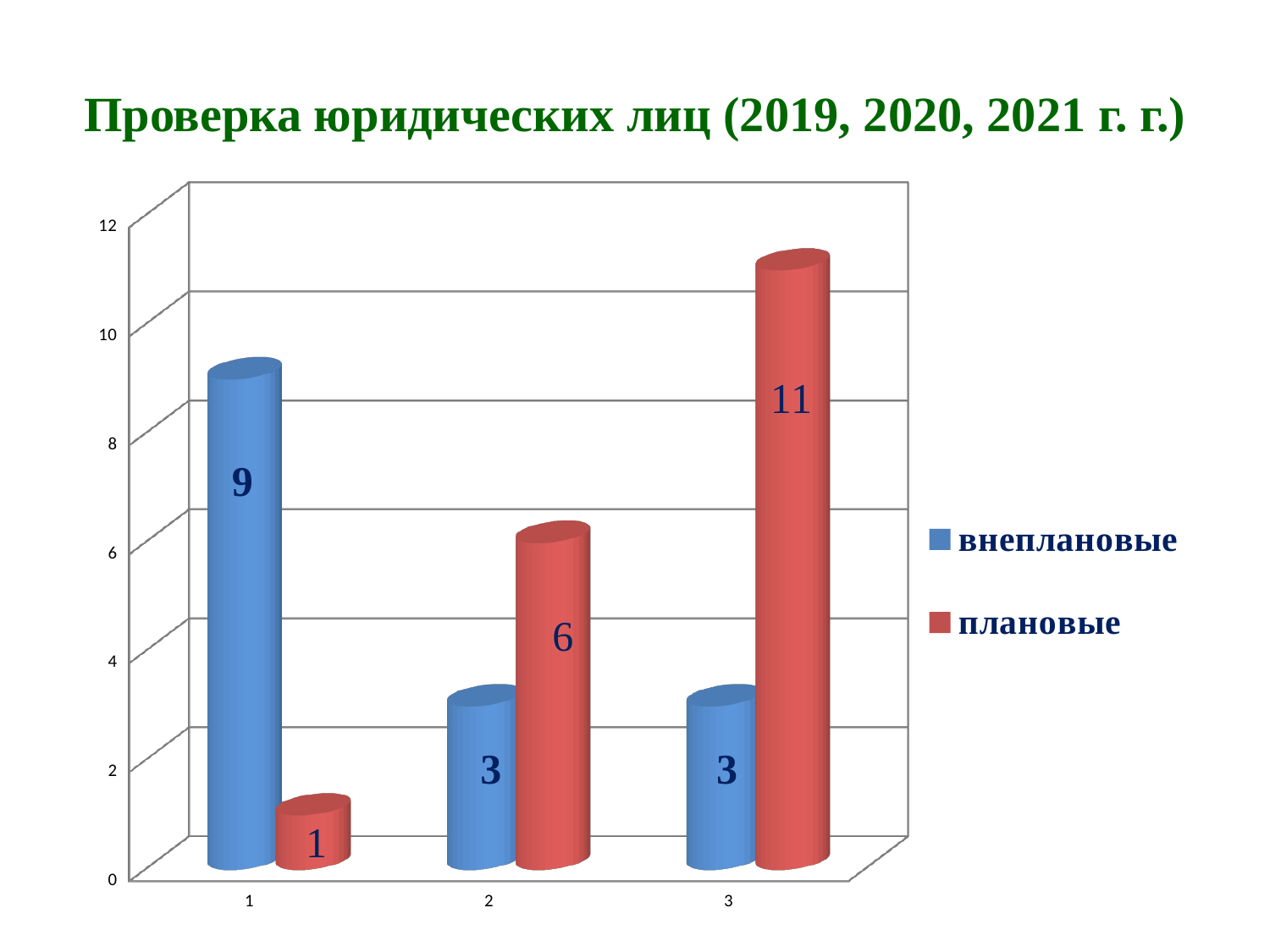
What kind of chart is shown on the slide? bar chart What is the difference between the плановые and внеплановые values in category 3? 8 What is the title of the slide? Проверка юридических лиц (2019, 2020, 2021 г. г.) What is the value for плановые in category 2? 6 What is the value for внеплановые in category 1? 9 How many series does the legend list? 2 In category 2, which series has the larger value, внеплановые or плановые? плановые In which category is the плановые value lowest? 1 What is the value for плановые in category 3? 11 What is the value for плановые in category 1? 1 How many categories are shown on the x axis? 3 In which category is the плановые value highest? 3